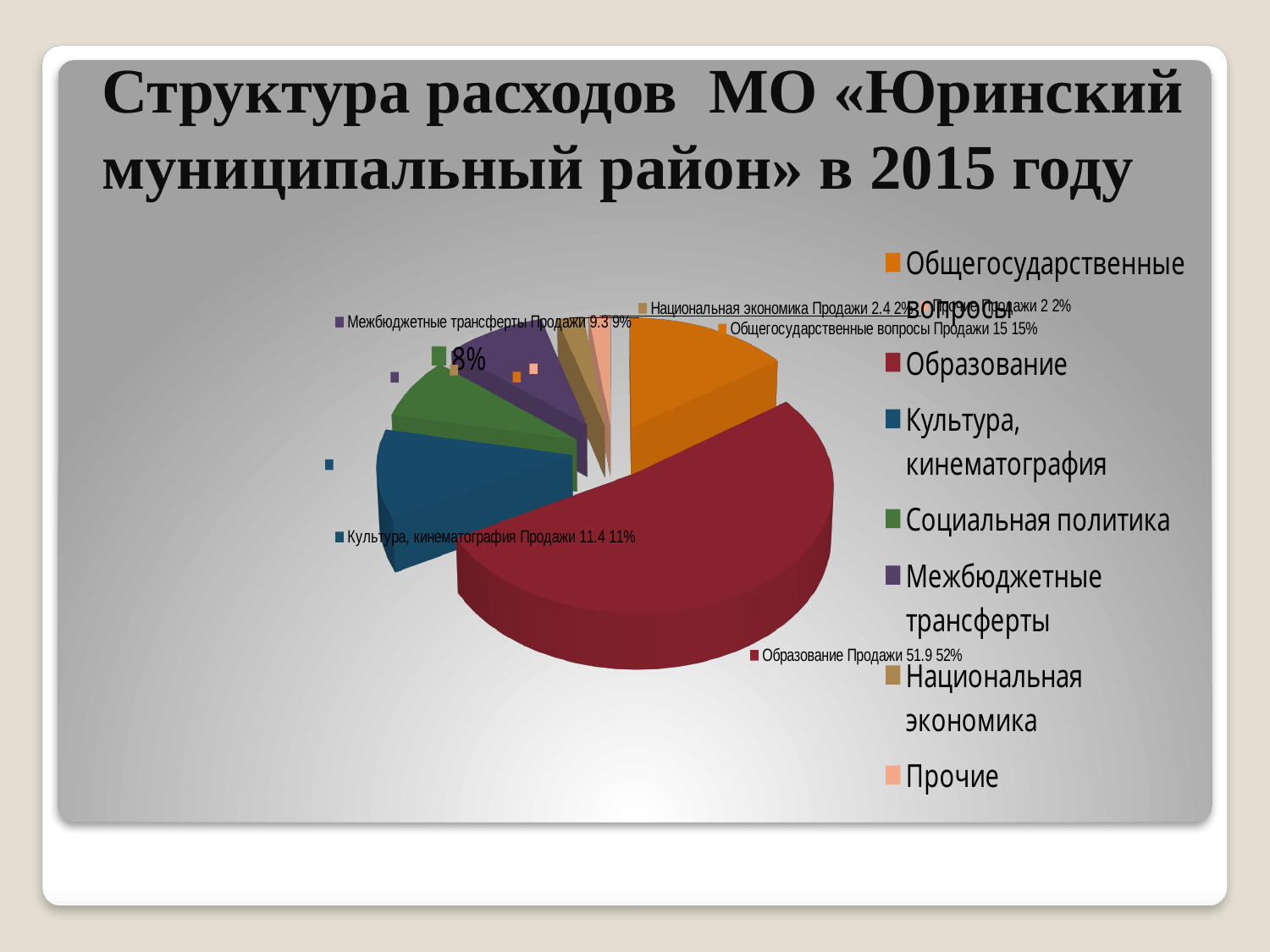
What percentage share does the Образование slice have? 52% What value is printed for Национальная экономика in the data label? 2.4 Which category has the largest slice of the pie? Образование What kind of chart is shown on the slide? pie chart What percentage share does the Общегосударственные вопросы slice have? 15% What value is printed for Культура, кинематография in the data label? 11.4 Which is larger, the value for Общегосударственные вопросы or the value for Межбюджетные трансферты? Общегосударственные вопросы What colour is the Образование slice in the pie chart? dark red What percentage share does the Межбюджетные трансферты slice have? 9% What value is printed for Образование in the data label? 51.9 How many categories does the legend of the pie chart list? 7 What is the difference between the printed values for Образование (51.9) and Культура, кинематография (11.4)? 40.5